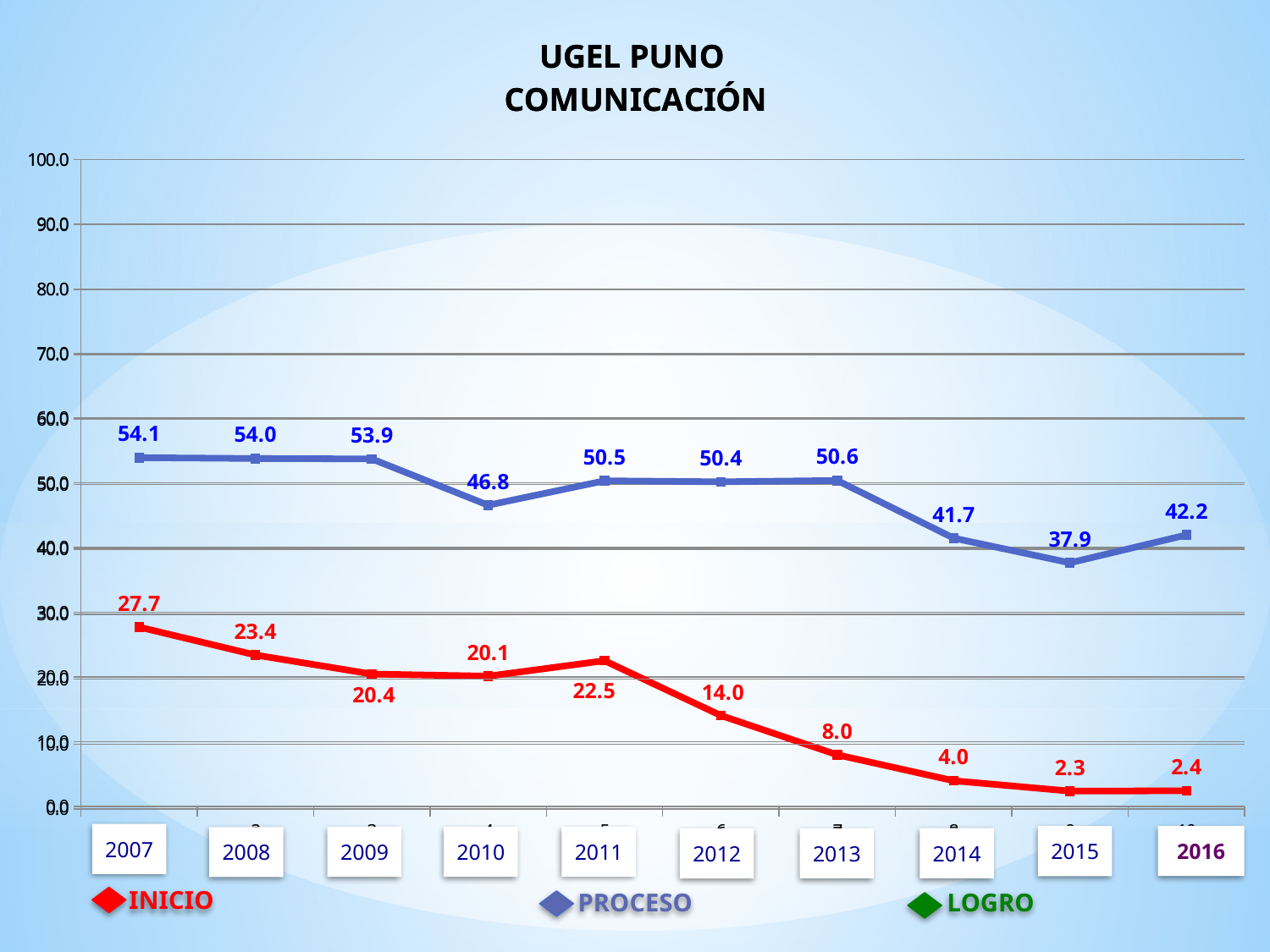
In which year is the PROCESO series lowest? 2015 What kind of chart is shown on the slide? line chart What is the PROCESO value for 2007? 54.1 In which year is the INICIO series highest? 2007 What is the difference between the PROCESO and INICIO values in 2011? 28.0 Does the INICIO series generally rise or fall from 2007 to 2016? fall What is the PROCESO value for 2015? 37.9 What is the INICIO value for 2013? 8.0 Which is larger, the INICIO value for 2008 or the INICIO value for 2012? 2008 How many series does the legend list? 3 What is the INICIO value for 2016? 2.4 How many years are shown on the x axis? 10